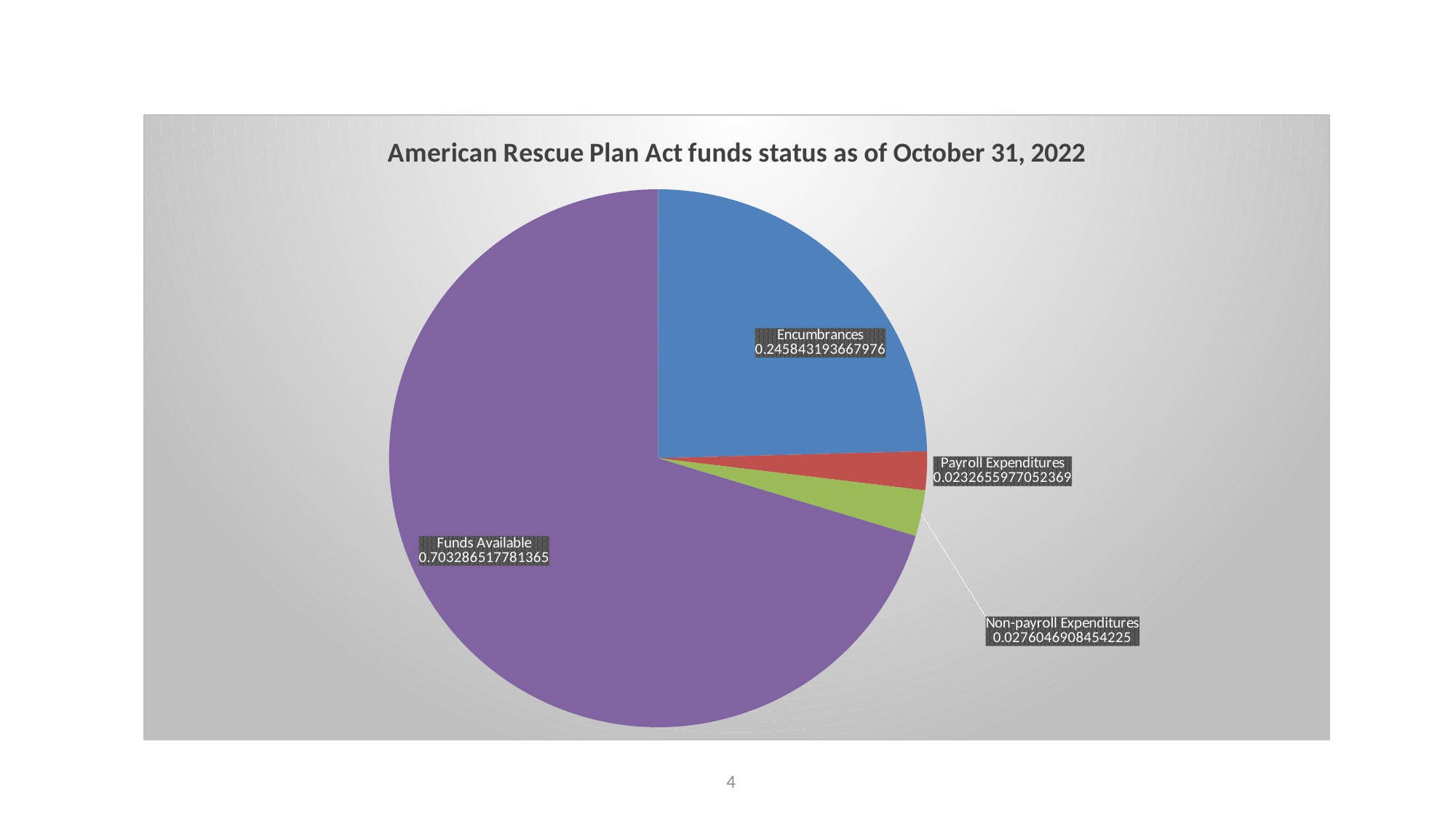
What colour is the Funds Available slice? Purple Which is larger, Encumbrances or Funds Available? Funds Available What is the value shown for Encumbrances? 0.245843193667976 What kind of chart is shown on the slide? Pie chart What is the value shown for Funds Available? 0.703286517781365 What is the value shown for Non-payroll Expenditures? 0.0276046908454225 What is the value shown for Payroll Expenditures? 0.0232655977052369 Which category has the largest slice of the pie? Funds Available Which category has the smallest slice of the pie? Payroll Expenditures Which is larger, Non-payroll Expenditures or Payroll Expenditures? Non-payroll Expenditures What is the title of the chart? American Rescue Plan Act funds status as of October 31, 2022 How many slices does the pie chart have? 4